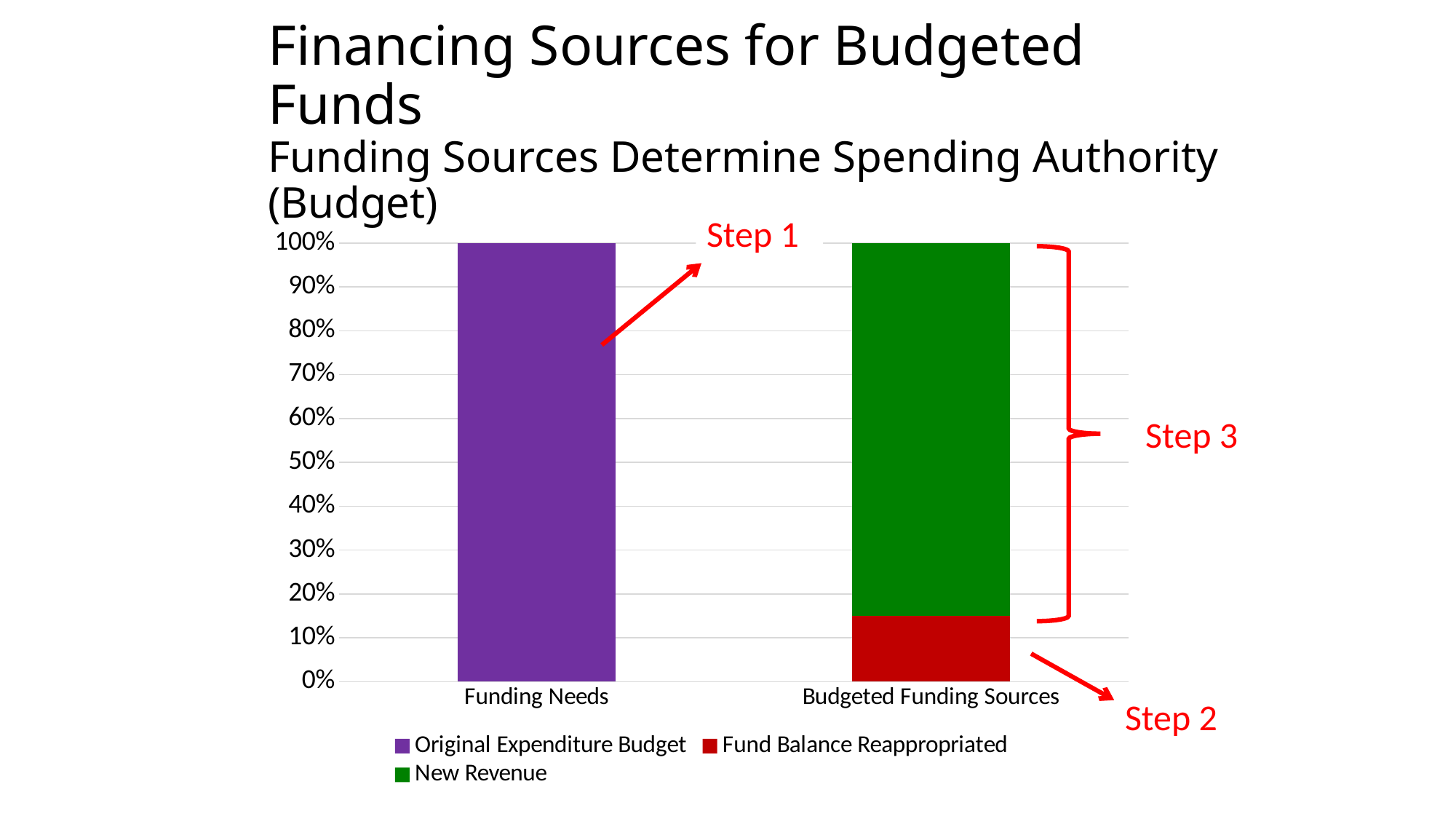
What kind of chart is shown on the slide? bar chart What is the value of Original Expenditure Budget for Funding Needs? 100% In the Budgeted Funding Sources bar, which is larger: New Revenue or Fund Balance Reappropriated? New Revenue Is the value for Fund Balance Reappropriated in Budgeted Funding Sources greater or less than 20%? less How many series make up the Budgeted Funding Sources bar? 2 What is the total height of the Budgeted Funding Sources stacked bar? 100% Is the value for Fund Balance Reappropriated in Budgeted Funding Sources greater or less than 10%? greater Which series makes up the Funding Needs bar? Original Expenditure Budget How many categories are shown on the x axis of the chart? 2 How many series does the chart's legend list? 3 Is the value for New Revenue in Budgeted Funding Sources greater or less than 80%? greater What colour represents New Revenue in the chart? green